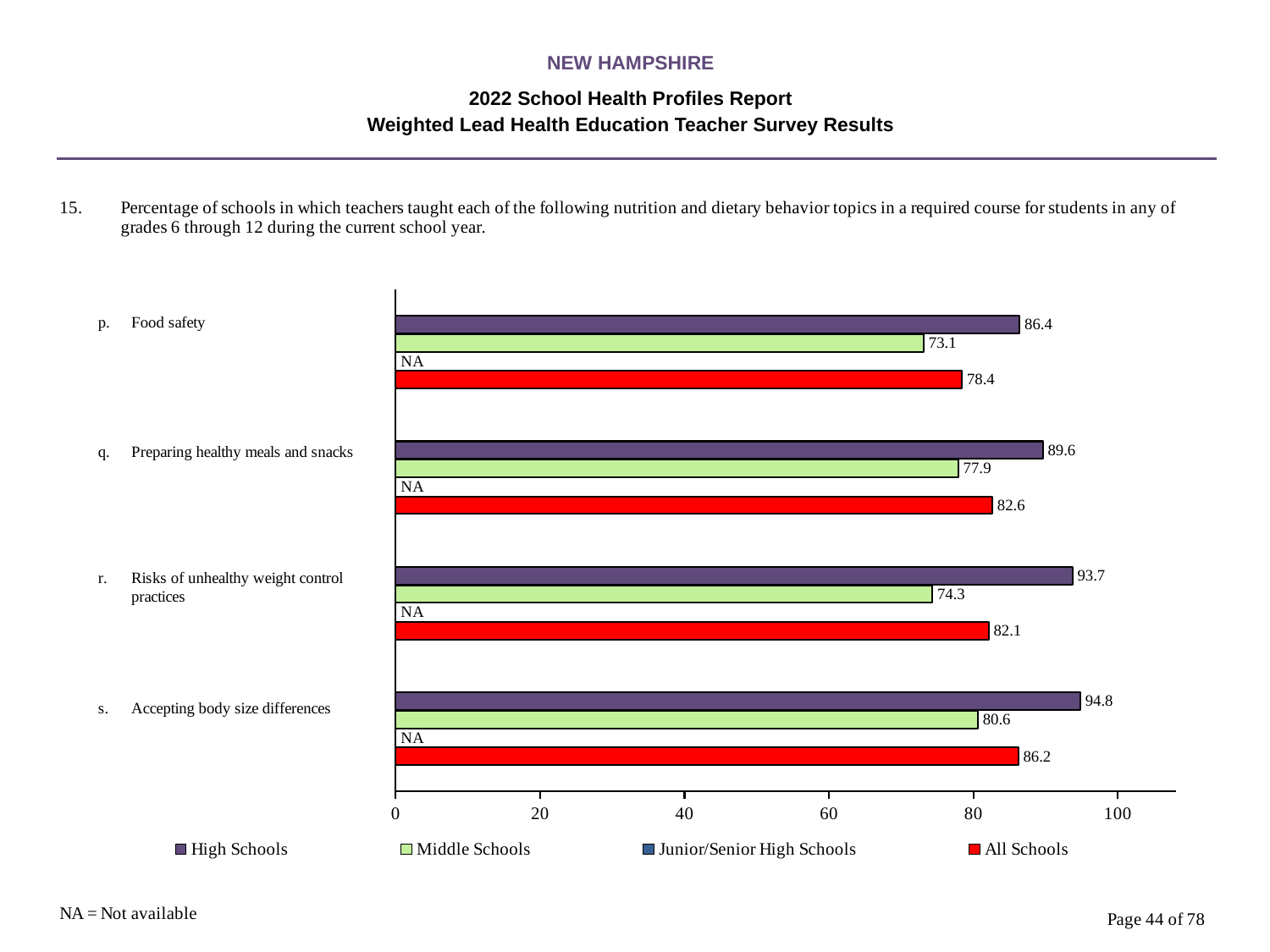
What is the value for High Schools for Food safety? 86.4 Which is larger for Food safety: the All Schools value or the Middle Schools value? All Schools What is the value for Middle Schools for Preparing healthy meals and snacks? 77.9 How many topics are shown on the chart? 4 How many series does the legend list? 4 What kind of chart is shown? bar chart Which topic has the highest value for High Schools? Accepting body size differences Is the All Schools value for Preparing healthy meals and snacks greater or less than 80? greater What is the value for All Schools for Risks of unhealthy weight control practices? 82.1 What is the difference between the High Schools and Middle Schools values for Accepting body size differences? 14.2 What is the value for Junior/Senior High Schools for Accepting body size differences? NA Which topic has the lowest value for Middle Schools? Food safety